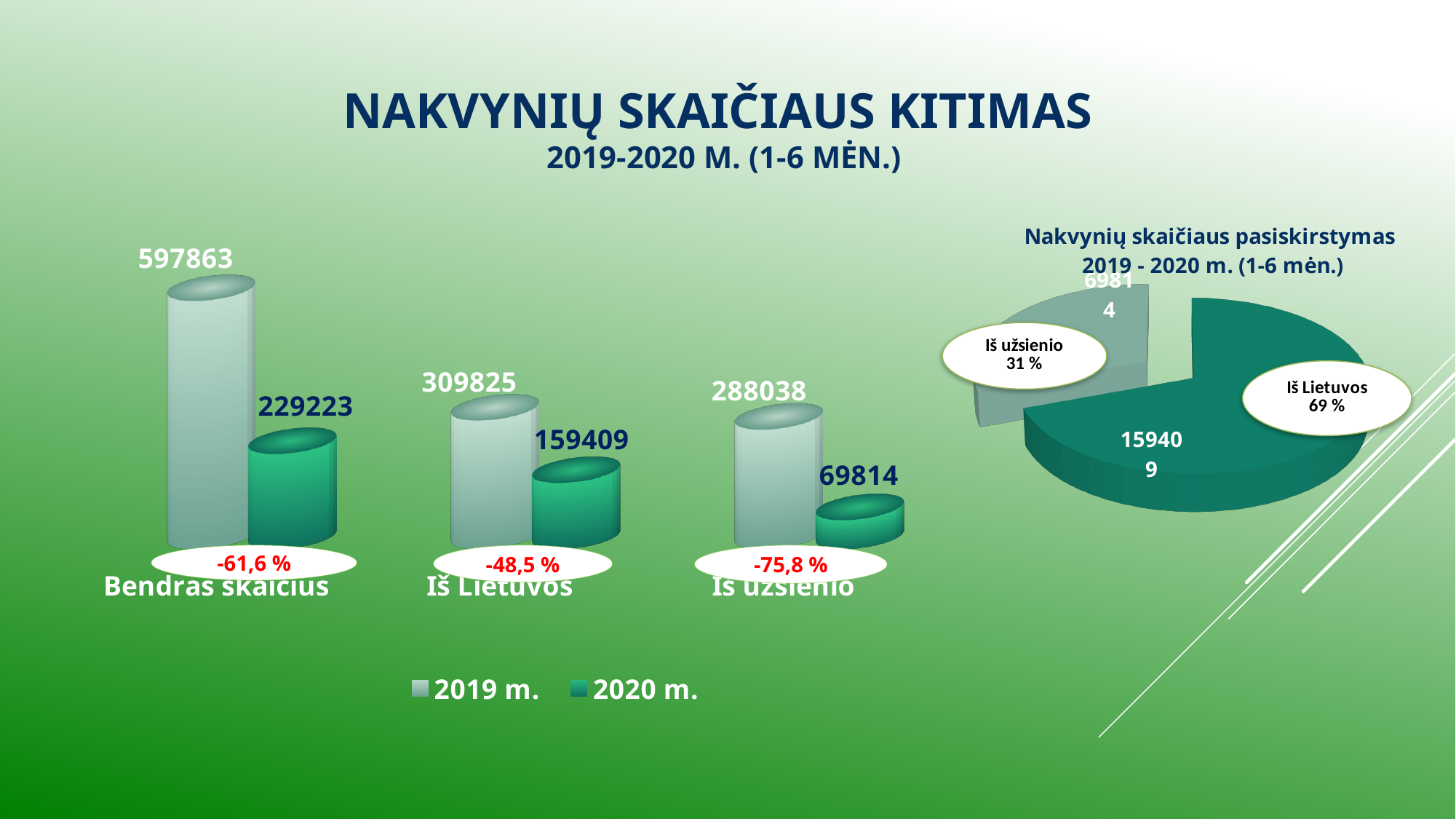
How many series does the legend of the bar chart on the left list? 2 In the bar chart on the left, what is the value for Iš Lietuvos in 2020 m.? 159409 In the bar chart on the left, which category has the lowest 2020 m. value? Iš užsienio In the bar chart on the left, which is larger: the 2019 m. value for Iš Lietuvos or the 2019 m. value for Iš užsienio? Iš Lietuvos What type of chart is the chart on the right of the slide? Pie chart How many categories are shown in the bar chart on the left? 3 In the pie chart titled 'Nakvynių skaičiaus pasiskirstymas', what share does Iš Lietuvos have? 69 % In the bar chart on the left, what is the value for Bendras skaičius in 2019 m.? 597863 In the bar chart on the left, which category has the highest 2019 m. value? Bendras skaičius In the bar chart on the left, what percentage change is shown for Iš užsienio? -75,8 % In the bar chart on the left, what is the difference between the 2019 m. and 2020 m. values for Bendras skaičius? 368640 In the bar chart on the left, what is the value for Iš užsienio in 2020 m.? 69814